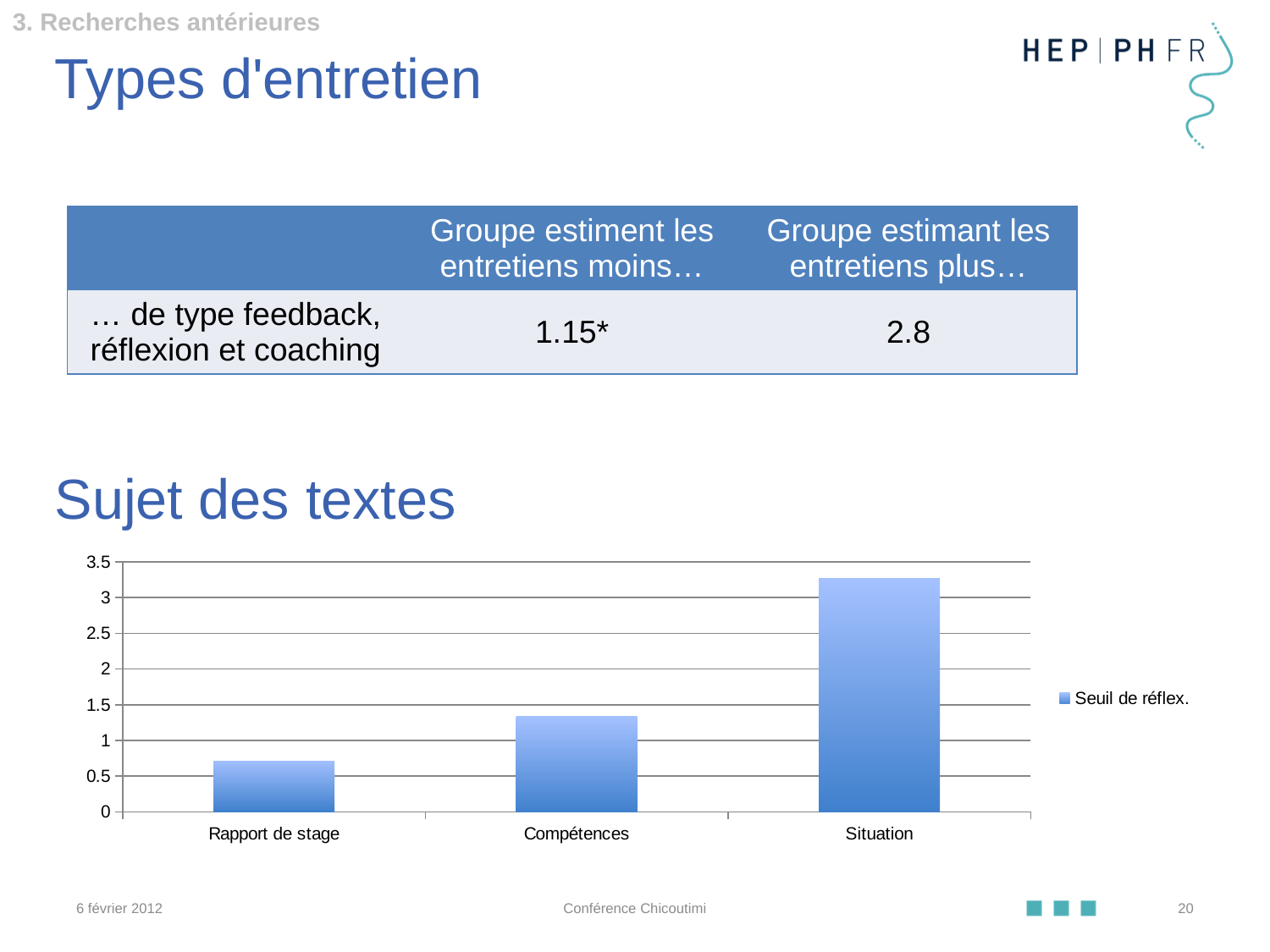
Which category has the highest bar in the chart? Situation How many categories are shown on the x axis of the bar chart? 3 Is the value for Situation greater or less than 3? greater Is the value for Rapport de stage greater or less than 1? less What is the maximum value shown on the y axis of the chart? 3.5 Which is larger in the chart, the value for Compétences or the value for Rapport de stage? Compétences What is the name of the series shown in the chart's legend? Seuil de réflex. Do the bar values rise or fall from left to right across the x axis? rise Which category has the lowest bar in the chart? Rapport de stage What kind of chart is shown under the heading 'Sujet des textes'? bar chart How many series does the legend of the bar chart list? 1 Is the value for Compétences greater or less than 1? greater